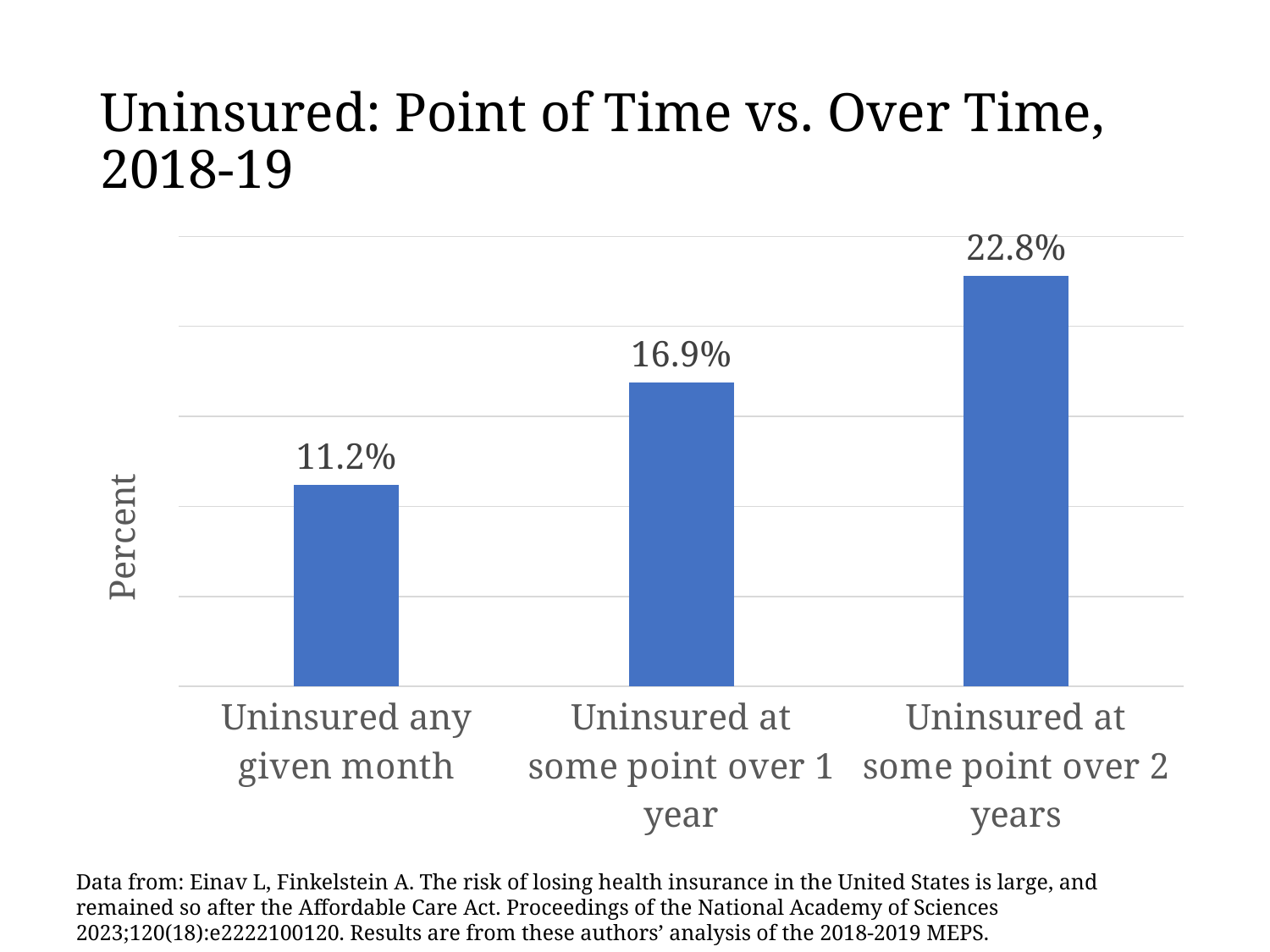
What is the value for 'Uninsured any given month'? 11.2% Which is larger: the value for 'Uninsured at some point over 1 year' or 'Uninsured any given month'? Uninsured at some point over 1 year Do the values rise or fall from left to right across the categories? Rise What kind of chart is shown on the slide? Bar chart Which category has the highest value? Uninsured at some point over 2 years What is the difference between the values for 'Uninsured at some point over 2 years' and 'Uninsured any given month'? 11.6% Which category has the lowest value? Uninsured any given month What is the value for 'Uninsured at some point over 2 years'? 22.8% What is the label of the vertical axis? Percent How many categories are shown in the chart? 3 What is the value for 'Uninsured at some point over 1 year'? 16.9% What is the difference between the values for 'Uninsured at some point over 1 year' and 'Uninsured any given month'? 5.7%